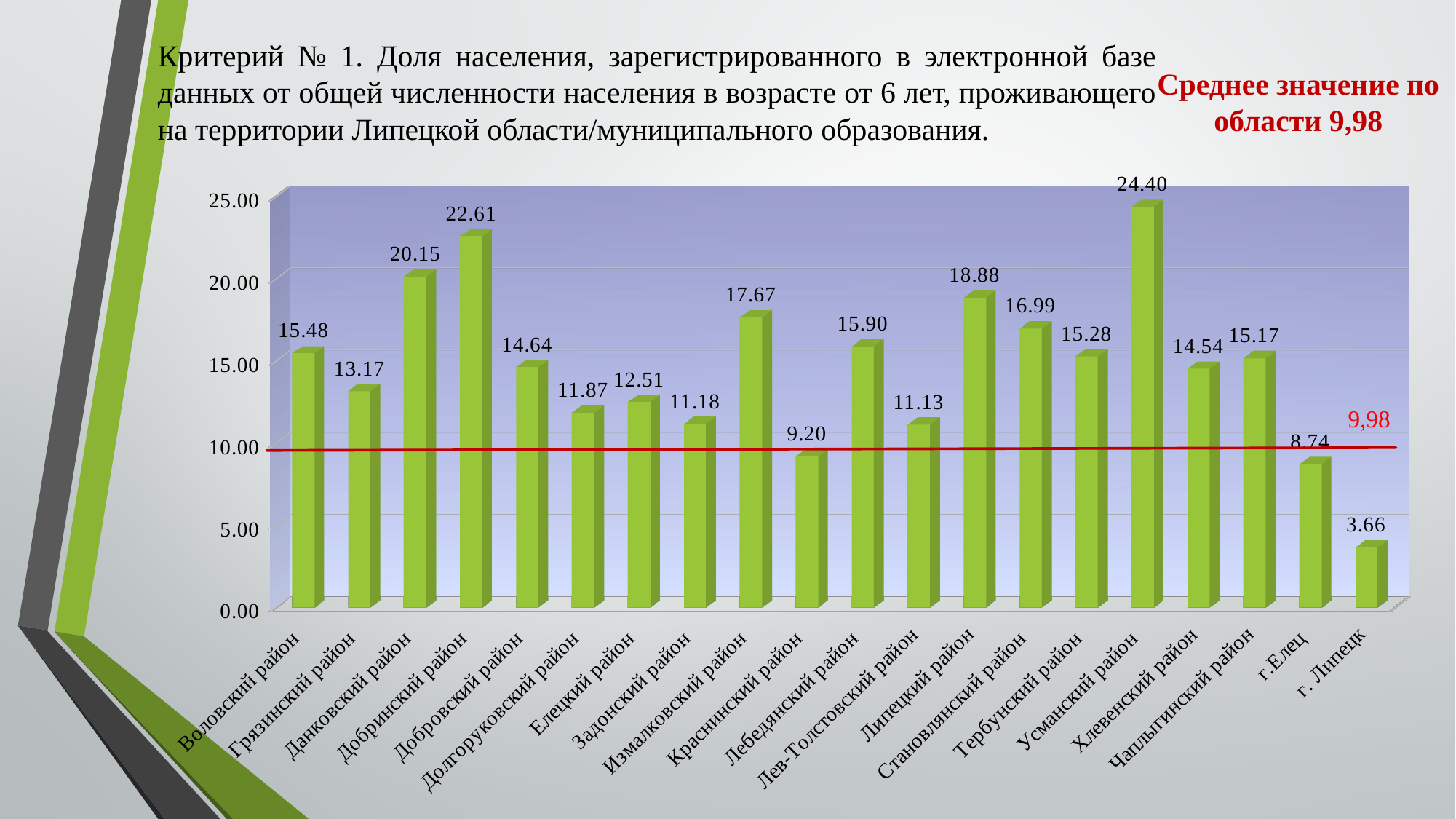
Which category has the lowest value? г. Липецк What is the value for Краснинский район? 9.20 What is the value for Липецкий район? 18.88 What is the value for Усманский район? 24.40 How many categories are shown on the x axis? 20 Which category has the highest value? Усманский район Which is larger, the value for Измалковский район or the value for Становлянский район? Измалковский район What is the difference between the values for Добринский район and Данковский район? 2.46 Is the value for г.Елец greater or less than 10.00? less How many bars fall below the red average line? 3 What value does the red horizontal line represent? 9,98 What kind of chart is this? bar chart